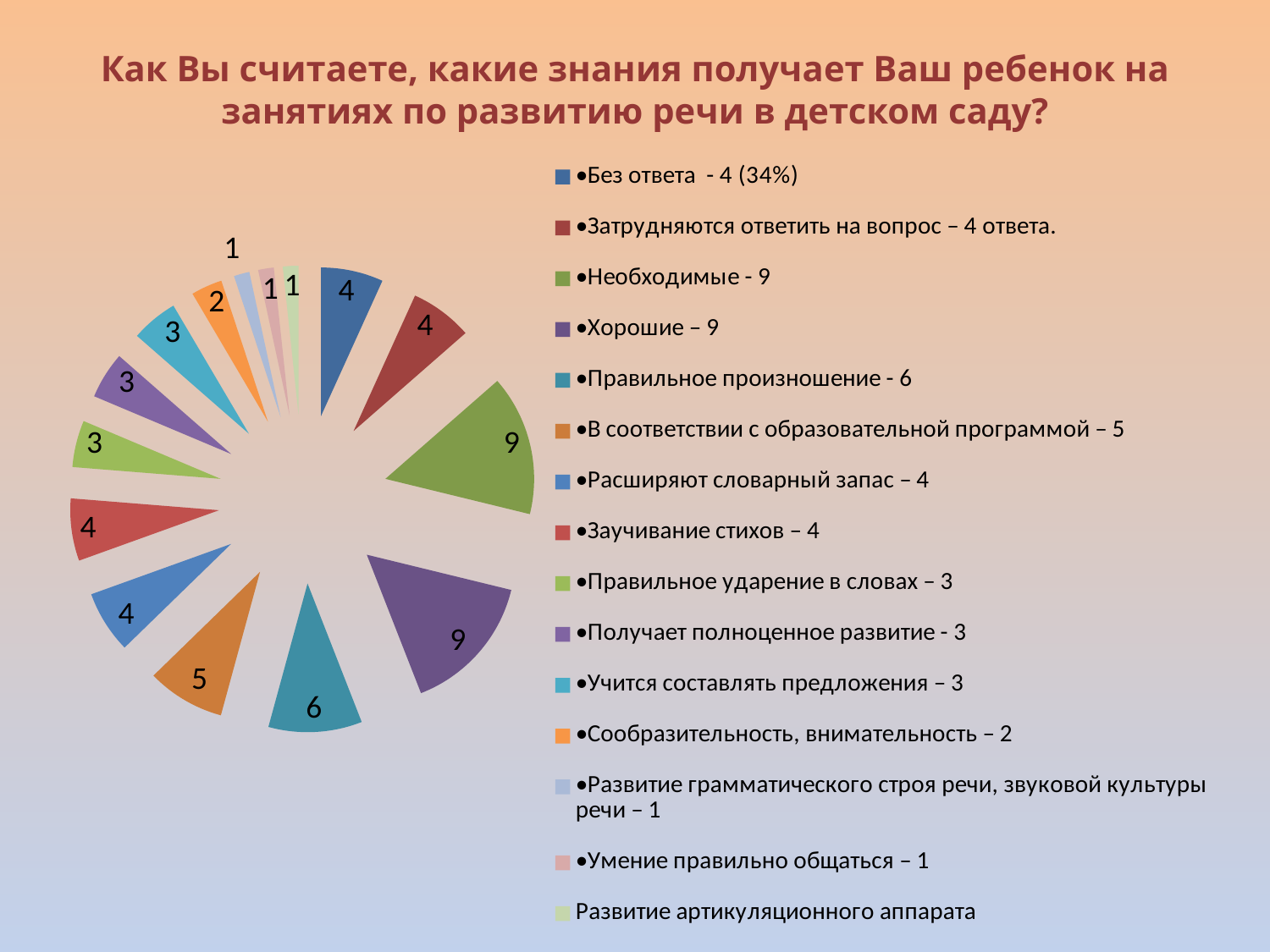
How many slices does the pie chart have? 15 What is the value for «Учится составлять предложения»? 3 What is the value for «Сообразительность, внимательность»? 2 What is the difference between the values for «Необходимые» and «Правильное произношение»? 3 What is the smallest value shown on the pie chart? 1 What is the largest value shown on the pie chart? 9 What kind of chart is shown on the slide? pie chart What is the value for «Заучивание стихов»? 4 What is the value for «Правильное произношение»? 6 What is the value for «В соответствии с образовательной программой»? 5 What is the title of the slide? Как Вы считаете, какие знания получает Ваш ребенок на занятиях по развитию речи в детском саду? Which is larger: «Правильное произношение» or «В соответствии с образовательной программой»? Правильное произношение